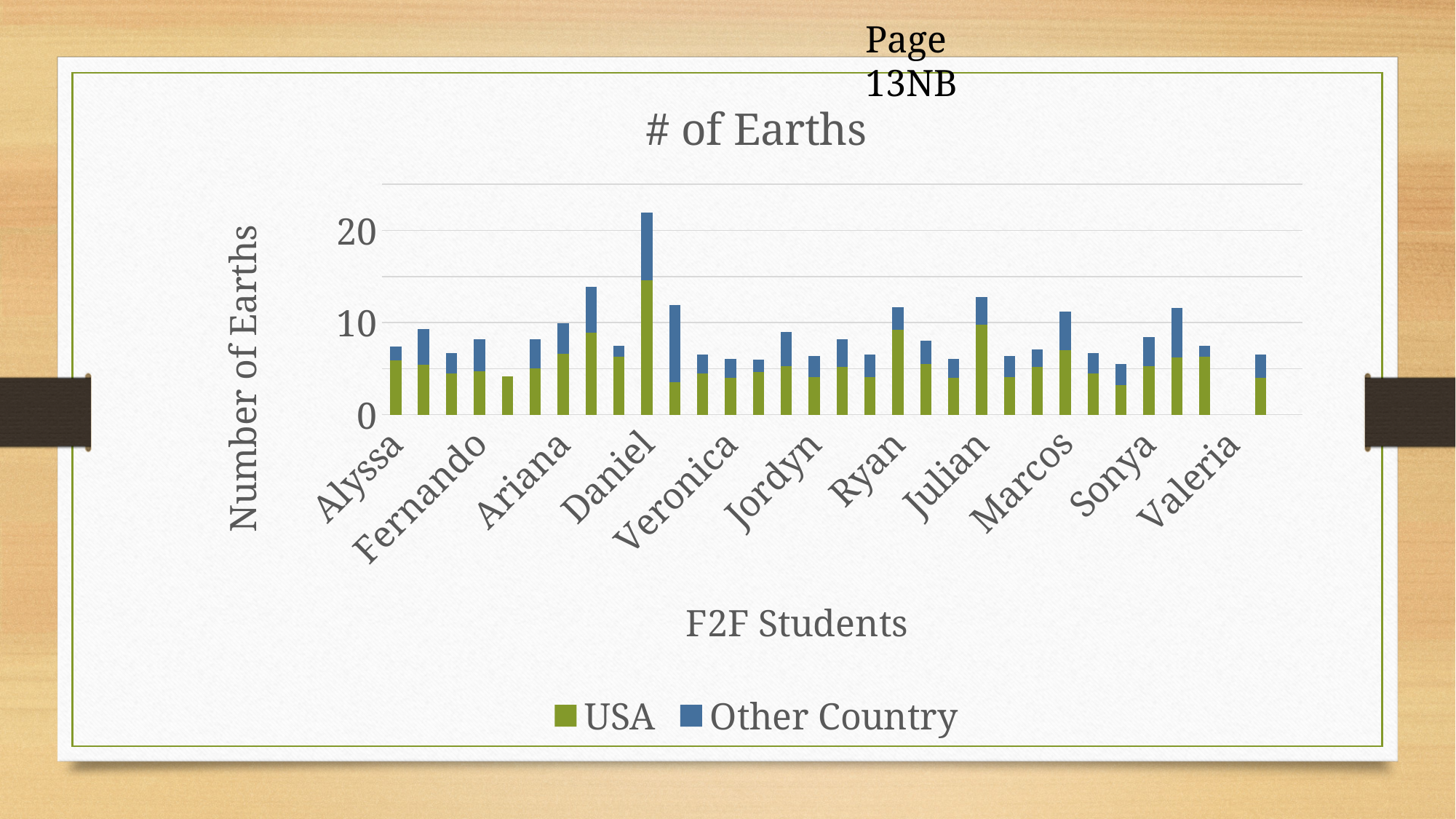
Is the total value for Julian greater or less than 10? greater Which has the larger total number of Earths, Julian or Jordyn? Julian What is the label on the vertical axis? Number of Earths Which student has the highest total number of Earths? Daniel Which has the larger total number of Earths, Daniel or Alyssa? Daniel Is the total value for Alyssa greater or less than 10? less Is the total value for Veronica greater or less than 10? less How many series does the legend list? 2 What is the title of the chart? # of Earths What kind of chart is shown on the slide? Stacked bar chart